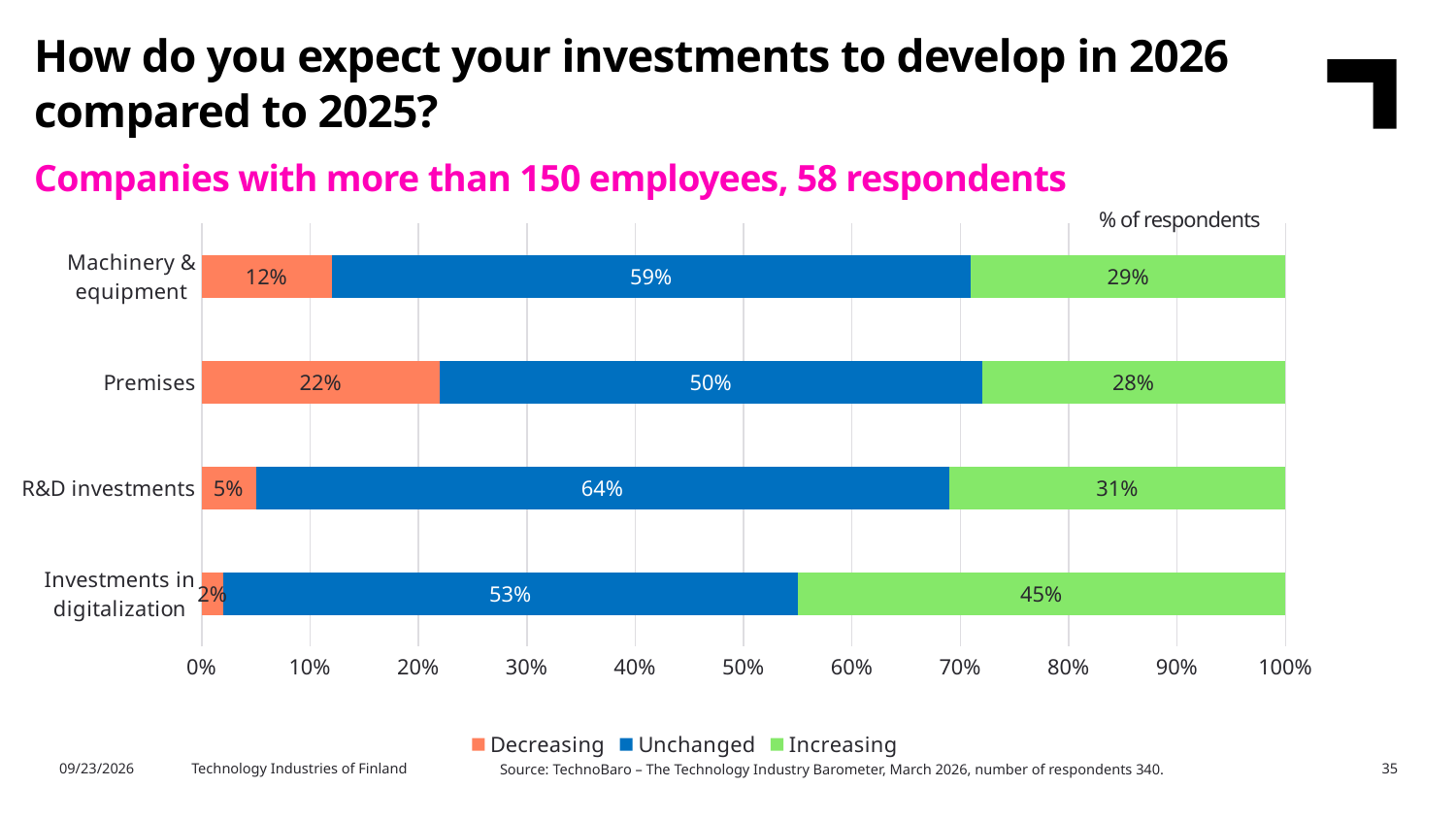
Which category has the lowest share of respondents expecting Decreasing investments? Investments in digitalization What kind of chart is shown on the slide? Stacked bar chart How many series does the legend list? 3 What percentage of respondents expect Premises investments to be Decreasing? 22% How many investment categories are shown in the chart? 4 What percentage of respondents expect R&D investments to be Decreasing? 5% Which category has the highest share of respondents expecting Increasing investments? Investments in digitalization Is the Decreasing share larger for Premises or for Machinery & equipment? Premises What is the difference between the Increasing share for Investments in digitalization and for Premises? 17 percentage points Which category has the highest share of respondents expecting Unchanged investments? R&D investments What percentage of respondents expect Investments in digitalization to be Increasing? 45% What percentage of respondents expect Machinery & equipment investments to be Unchanged? 59%